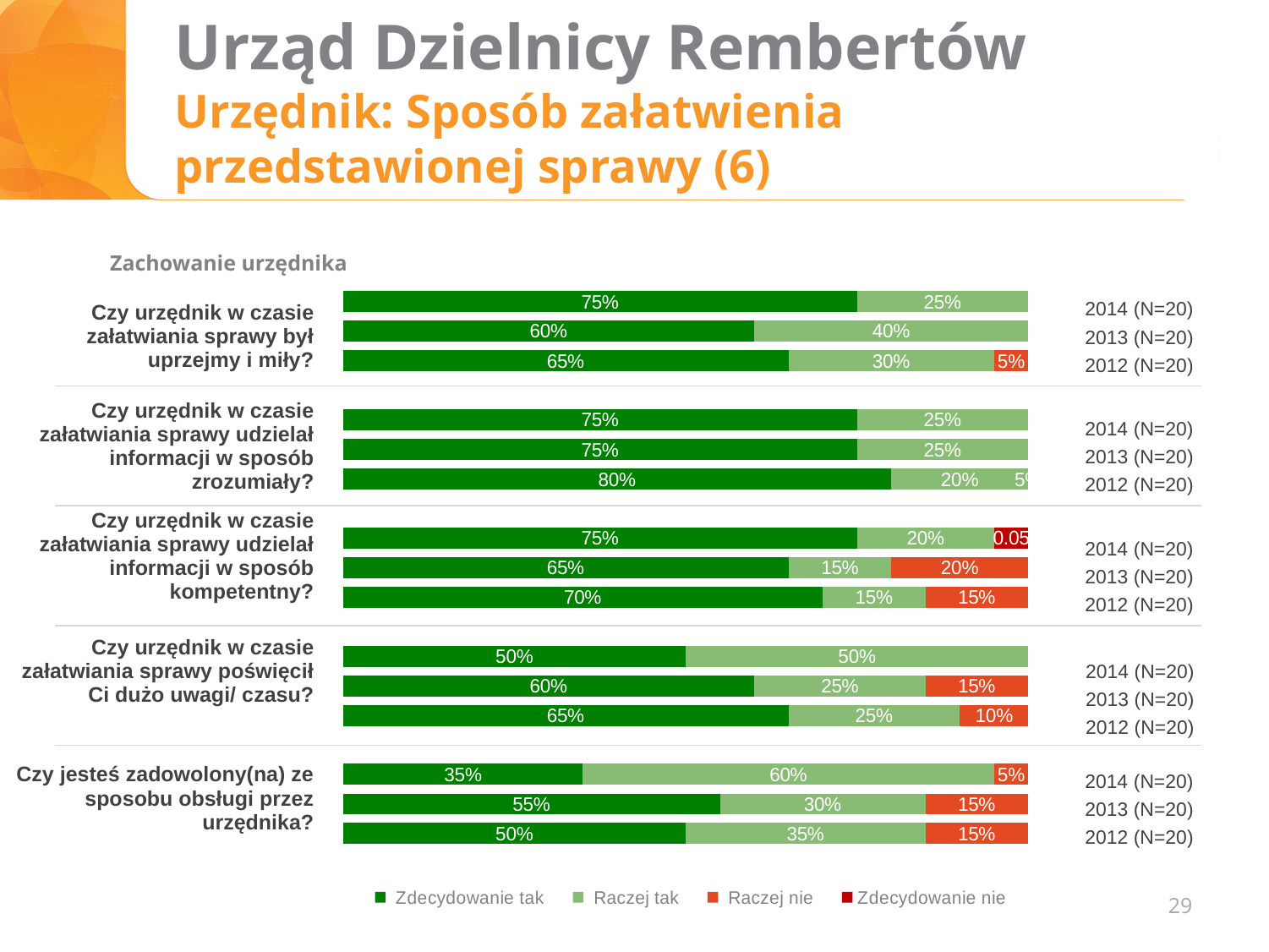
In the chart for "Czy urzędnik w czasie załatwiania sprawy był uprzejmy i miły?", what is the "Raczej tak" value for 2013 (N=20)? 40% In the chart for "Czy jesteś zadowolony(na) ze sposobu obsługi przez urzędnika?", is the "Zdecydowanie tak" value larger for 2013 or 2012? 2013 In the chart for "Czy urzędnik w czasie załatwiania sprawy udzielał informacji w sposób kompetentny?", what is the difference between the "Zdecydowanie tak" values for 2014 and 2013? 10% What kind of chart is used on this slide? Stacked bar chart In the chart for "Czy urzędnik w czasie załatwiania sprawy poświęcił Ci dużo uwagi/ czasu?", what is the "Raczej nie" value for 2012 (N=20)? 10% In the chart for "Czy urzędnik w czasie załatwiania sprawy udzielał informacji w sposób kompetentny?", what is the "Raczej nie" value for 2013 (N=20)? 20% In the chart for "Czy urzędnik w czasie załatwiania sprawy był uprzejmy i miły?", what is the "Zdecydowanie tak" value for 2014 (N=20)? 75% In the chart for "Czy urzędnik w czasie załatwiania sprawy udzielał informacji w sposób zrozumiały?", which year has the highest "Zdecydowanie tak" value? 2012 (N=20) How many bars (years) are shown in the chart for "Czy urzędnik w czasie załatwiania sprawy był uprzejmy i miły?"? 3 In the chart for "Czy jesteś zadowolony(na) ze sposobu obsługi przez urzędnika?", what is the "Raczej tak" value for 2014 (N=20)? 60% How many series does the legend at the bottom of the slide list? 4 In the chart for "Czy urzędnik w czasie załatwiania sprawy poświęcił Ci dużo uwagi/ czasu?", which year has the lowest "Zdecydowanie tak" value? 2014 (N=20)